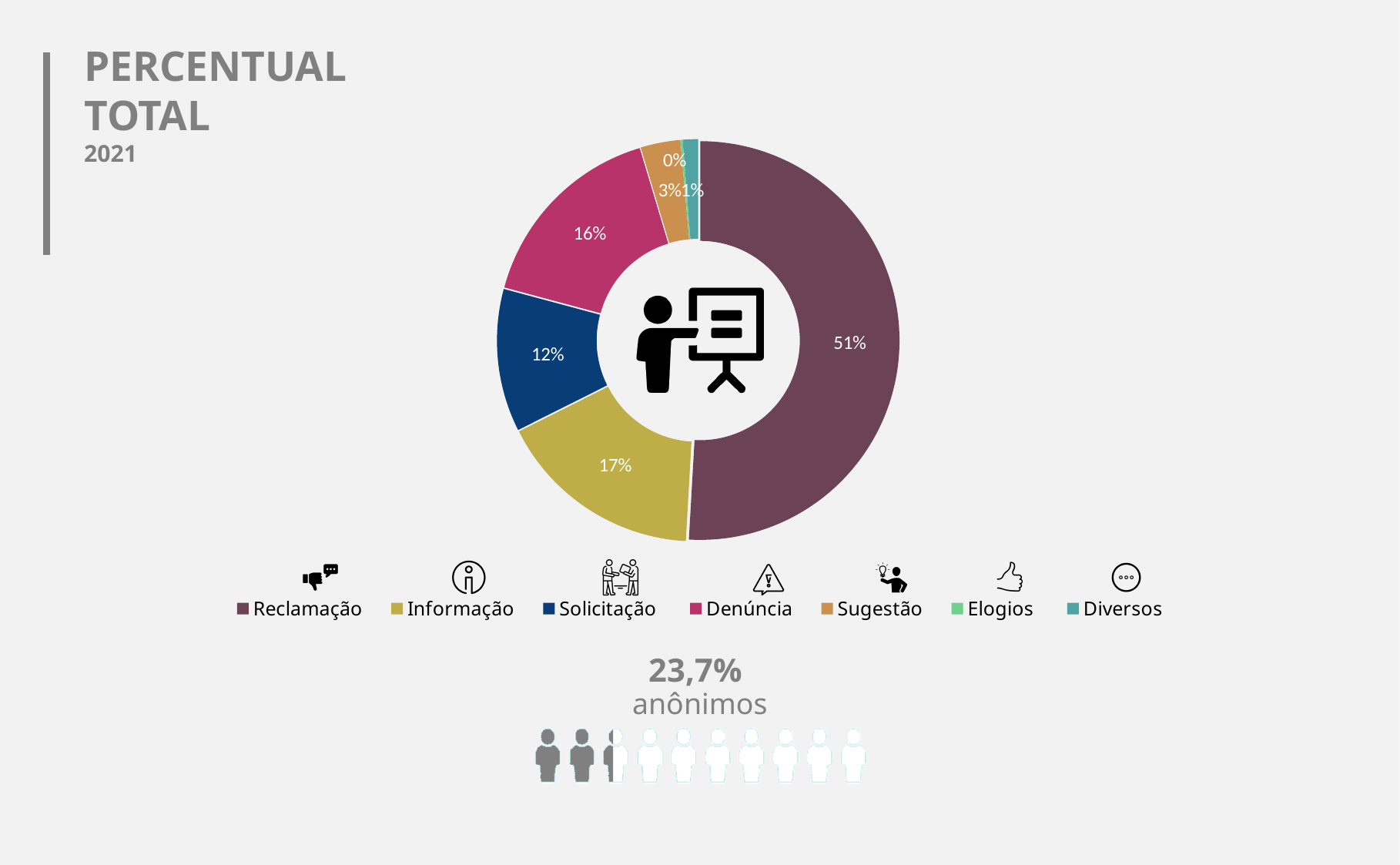
What is the difference in percentage points between Informação and Solicitação? 5 What percentage of the pie chart is Solicitação? 12% What year is shown under the chart title? 2021 What percentage of the pie chart is Reclamação? 51% Which category has the smallest share of the pie chart? Elogios How many categories does the legend of the pie chart list? 7 Which is larger, the share for Informação or the share for Denúncia? Informação What percentage of the pie chart is Denúncia? 16% What kind of chart is shown on the slide? Doughnut chart What percentage of the pie chart is Informação? 17% What percentage of the pie chart is Sugestão? 3% Which category has the largest share of the pie chart? Reclamação